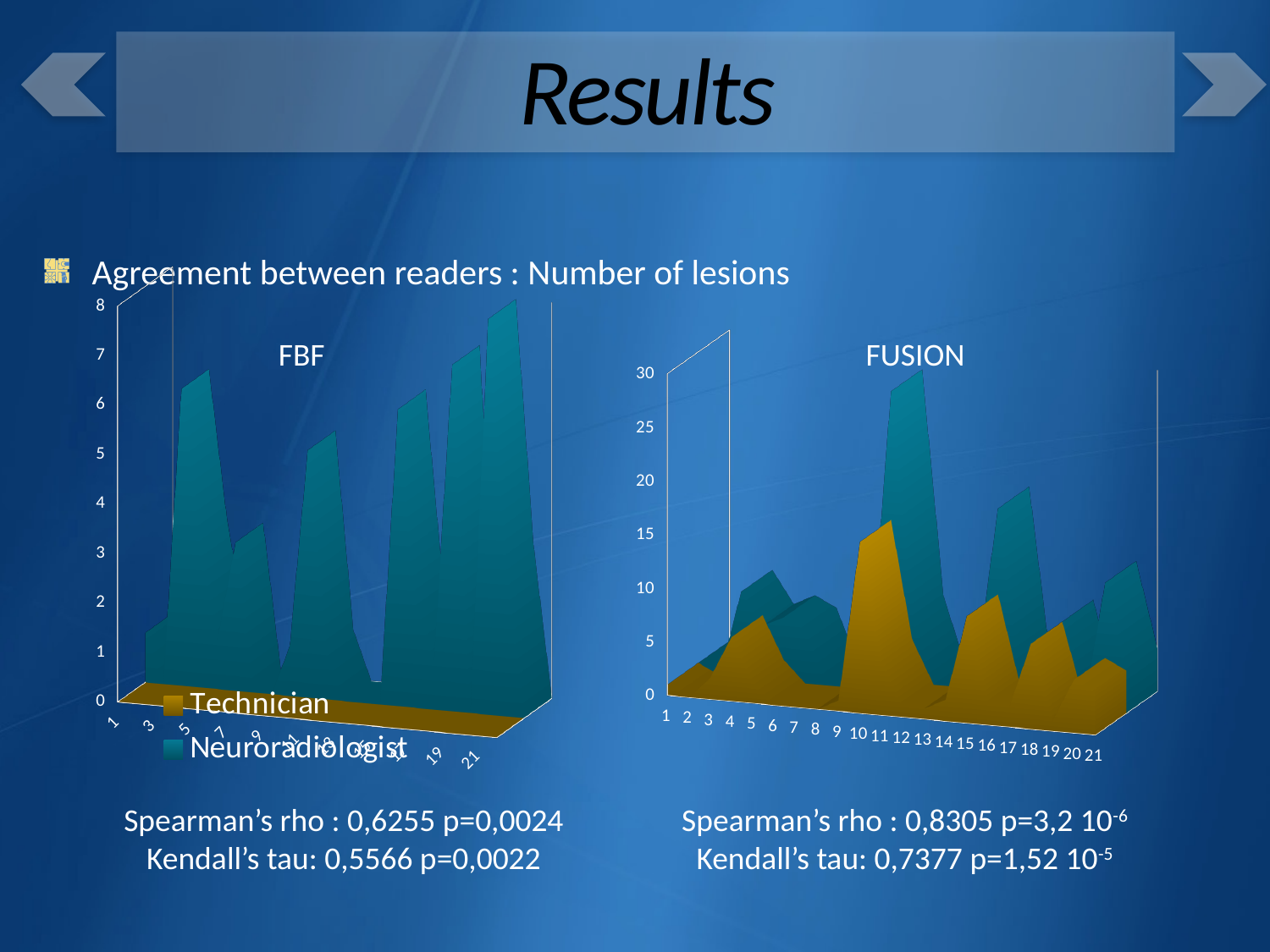
What is the highest value shown on the y axis of the FUSION chart? 30 What is the highest value shown on the y axis of the FBF chart? 8 What are the two series named in the legend? Technician and Neuroradiologist What kind of chart is the FUSION chart? area chart How many categories are shown on the x axis of the FUSION chart? 21 In the FUSION chart, is the highest Neuroradiologist value greater or less than 20? greater How many series does the legend list for the charts? 2 In the FBF chart, is the highest Neuroradiologist value greater or less than 5? greater What kind of chart is the FBF chart? area chart